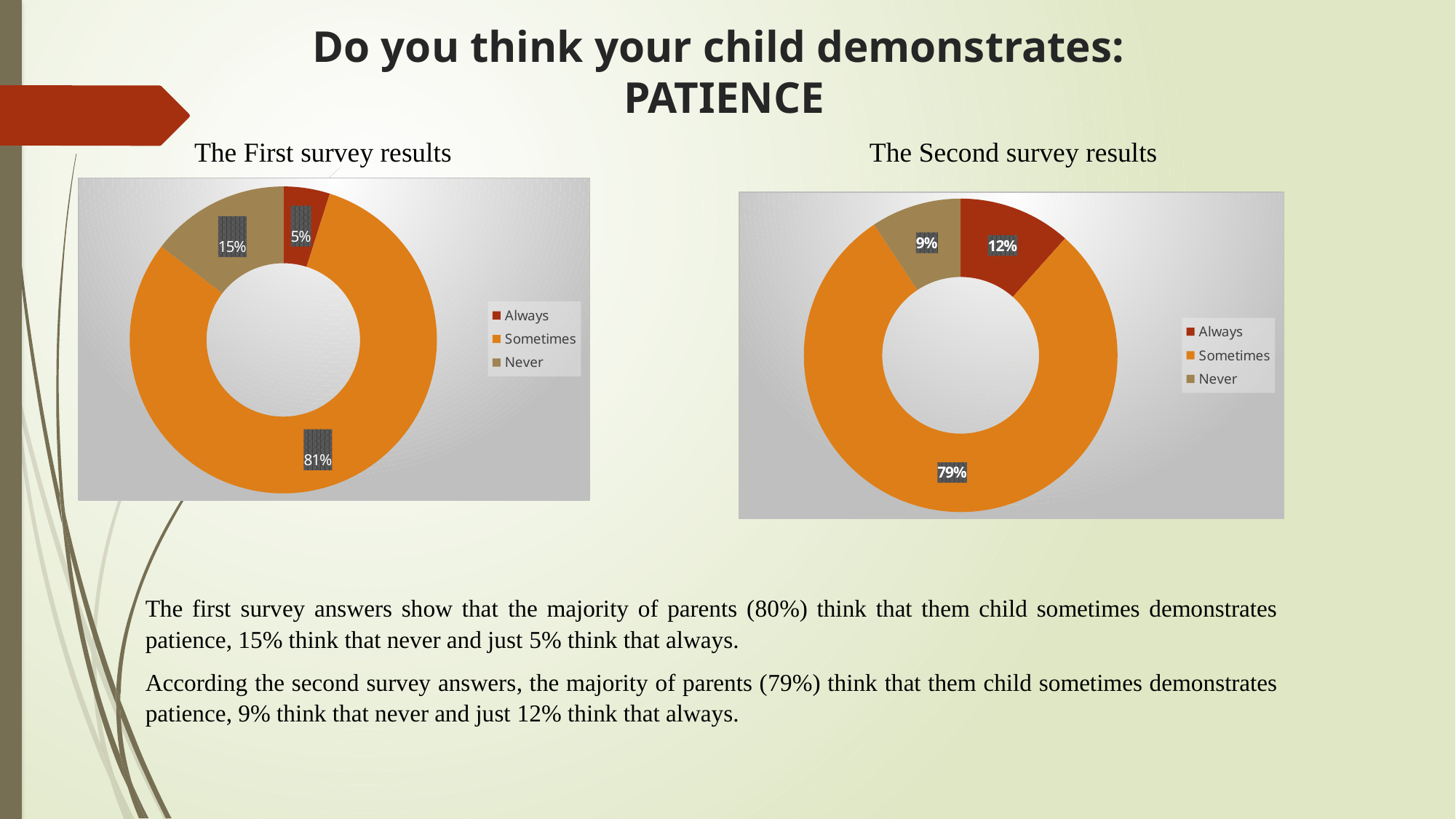
In the First survey results chart, what percentage of parents answered Never? 15% Which is larger in the First survey results chart: the Never share or the Always share? Never In the Second survey results chart, which answer has the largest share? Sometimes In the First survey results chart, which answer has the smallest share? Always In the Second survey results chart, what is the difference between the Always and Never shares? 3% What kind of chart is the First survey results chart? Doughnut chart In the First survey results chart, what percentage of parents answered Always? 5% In the First survey results chart, what percentage of parents answered Sometimes? 81% How many categories does the legend of the Second survey results chart list? 3 In the Second survey results chart, what percentage of parents answered Never? 9% In the Second survey results chart, what colour represents Sometimes? Orange In the Second survey results chart, what percentage of parents answered Always? 12%